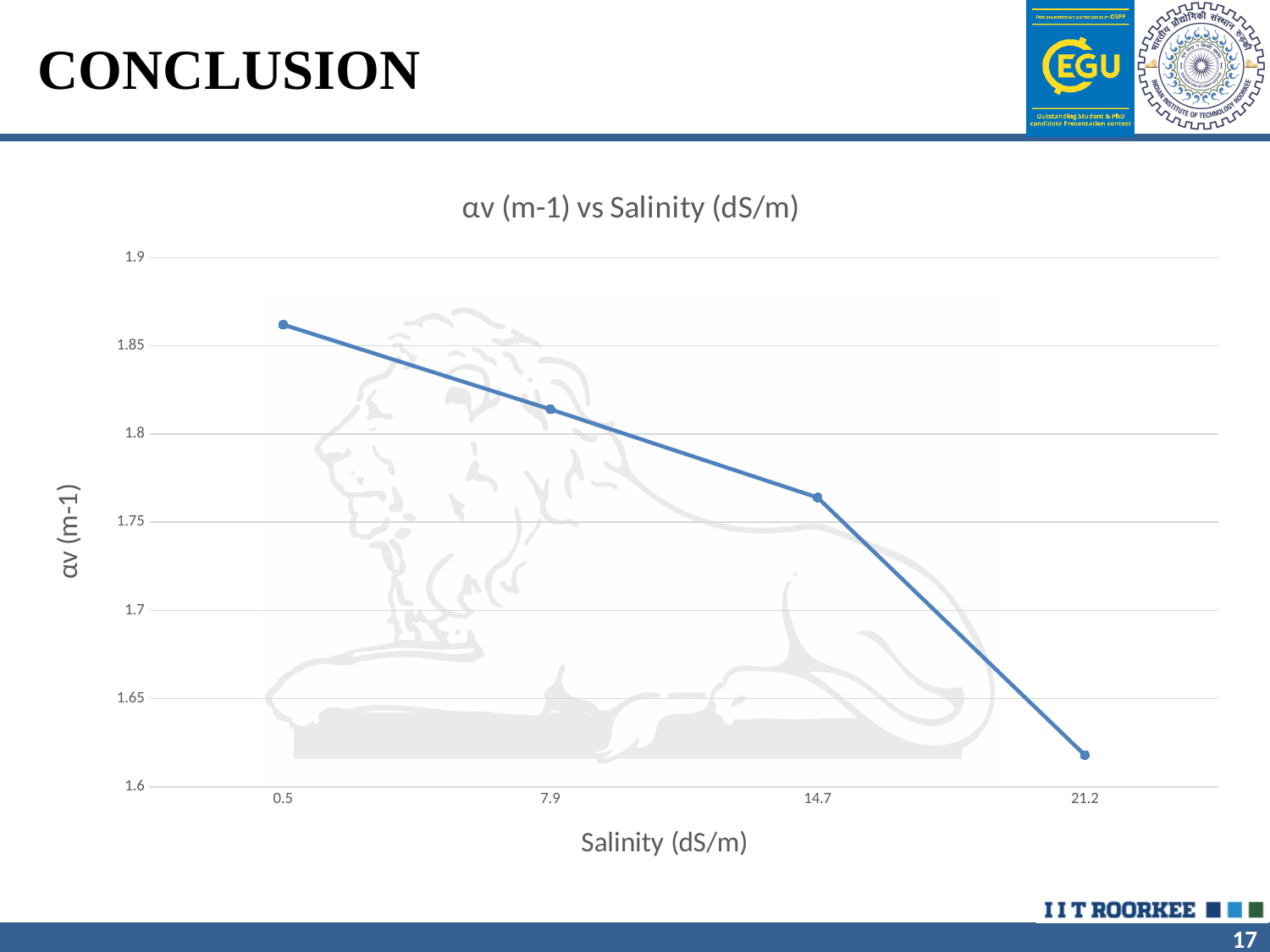
Does αv rise or fall as salinity increases along the x axis? fall Is the value of αv at salinity 7.9 greater or less than 1.8? greater Which has the larger αv value: salinity 7.9 or salinity 14.7? 7.9 What kind of chart is shown on the slide? line chart At which salinity value is αv highest? 0.5 Is the value of αv at salinity 21.2 greater or less than 1.65? less Is the value of αv at salinity 14.7 greater or less than 1.75? greater At which salinity value is αv lowest? 21.2 What is the title of the chart? αv (m-1) vs Salinity (dS/m) How many data points are plotted on the line? 4 What is the label of the x axis? Salinity (dS/m)